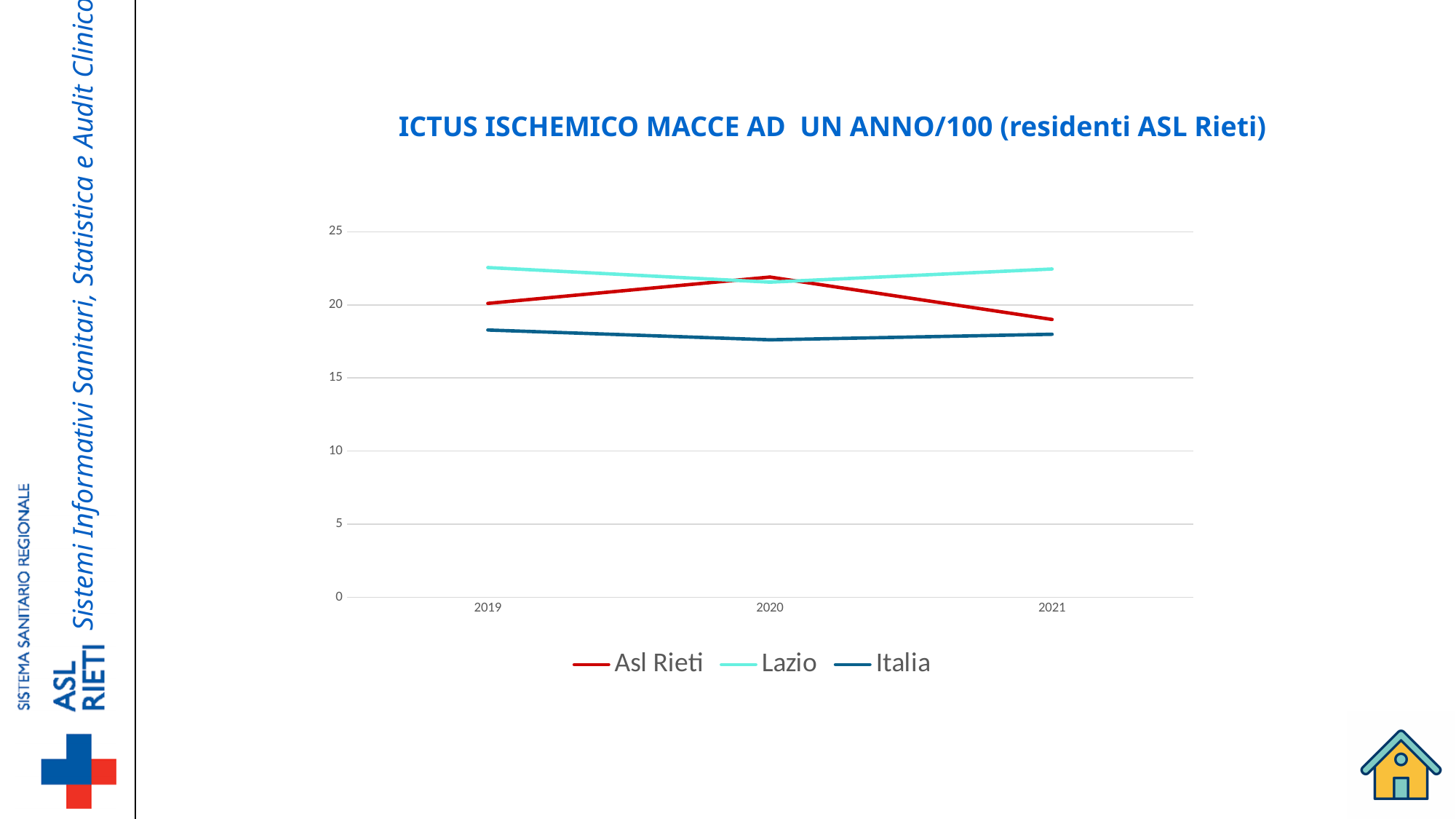
Is the value for Italia in 2020 greater or less than 20? less Which series has the lowest value in 2021? Italia Which series has the highest value in 2019? Lazio How many series does the legend list? 3 What kind of chart is shown on the slide? line chart Does the Asl Rieti line rise or fall from 2020 to 2021? fall How many years are shown on the x axis? 3 Is the value for Asl Rieti in 2021 greater or less than 20? less In 2019, which is larger: the value for Lazio or the value for Italia? Lazio Which series is drawn in red? Asl Rieti Is the value for Lazio in 2019 greater or less than 20? greater What is the title of the chart? ICTUS ISCHEMICO MACCE AD UN ANNO/100 (residenti ASL Rieti)